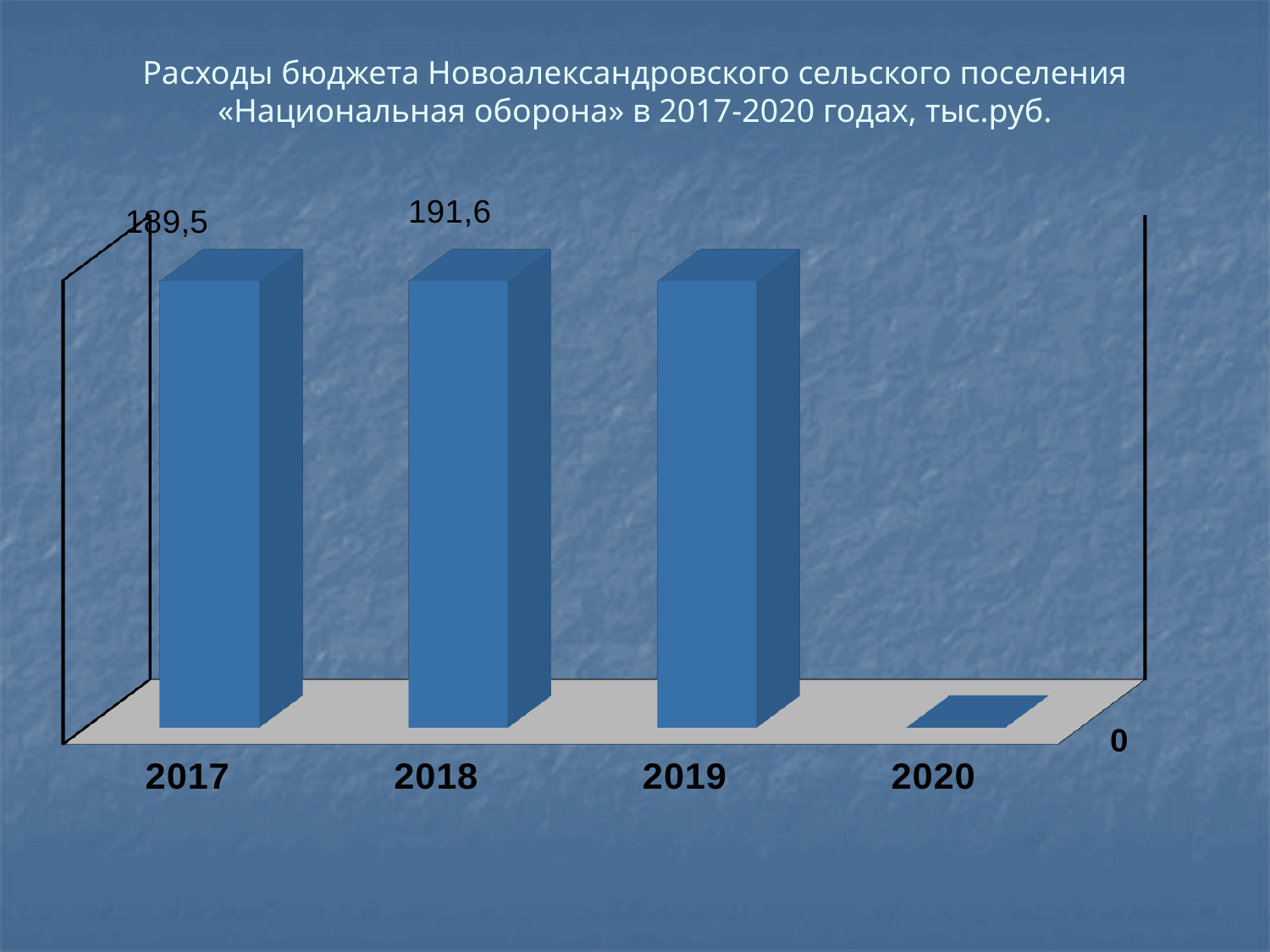
Do the values rise or fall from 2019 to 2020? fall What is the difference between the values for 2018 and 2017? 2,1 Which is larger, the value for 2017 or the value for 2018? 2018 What kind of chart is shown on the slide? bar chart How many years are shown on the x axis? 4 What is the value for 2018? 191,6 Which budget expenditure section does the chart title refer to? «Национальная оборона» What is the value for 2020? 0 Which is larger, the value for 2019 or the value for 2020? 2019 Which year has the lowest value? 2020 What is the value for 2017? 189,5 In what units are the values given according to the chart title? тыс.руб.